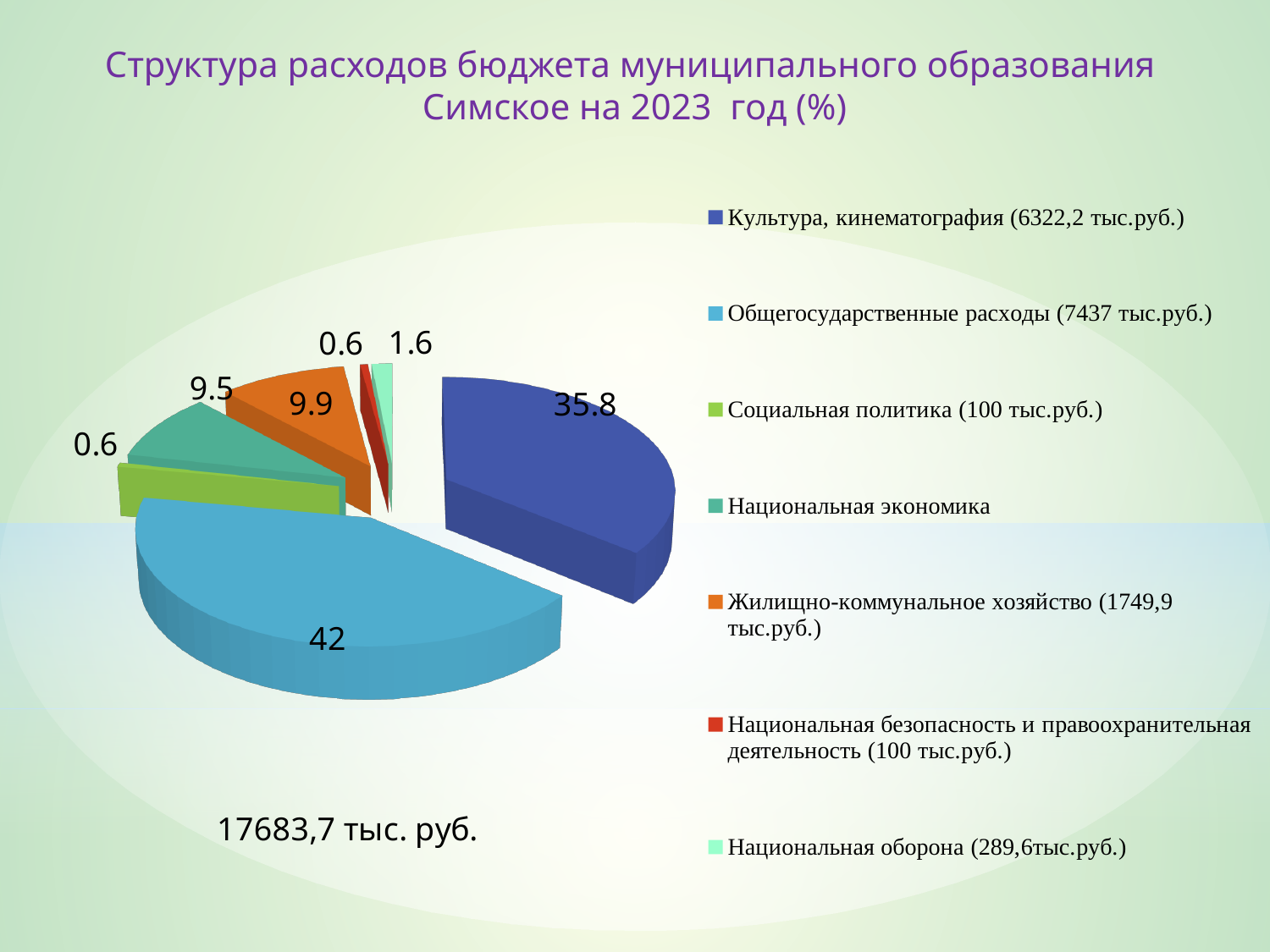
What percentage share does Национальная оборона have in the pie chart? 1.6 What amount in тыс. руб. is given in the legend for Культура, кинематография? 6322,2 тыс.руб. What kind of chart is shown on the slide? pie chart What is the difference in percentage points between the shares of Общегосударственные расходы and Культура, кинематография? 6.2 What percentage share does Национальная экономика have in the pie chart? 9.5 What percentage share does Культура, кинематография have in the pie chart? 35.8 How many categories does the legend of the pie chart list? 7 Which category has the largest share of the pie chart? Общегосударственные расходы What percentage share does Жилищно-коммунальное хозяйство have in the pie chart? 9.9 What total amount in тыс. руб. is printed below the pie chart? 17683,7 тыс. руб. Which has the larger share: Жилищно-коммунальное хозяйство or Национальная экономика? Жилищно-коммунальное хозяйство What percentage share does Общегосударственные расходы have in the pie chart? 42